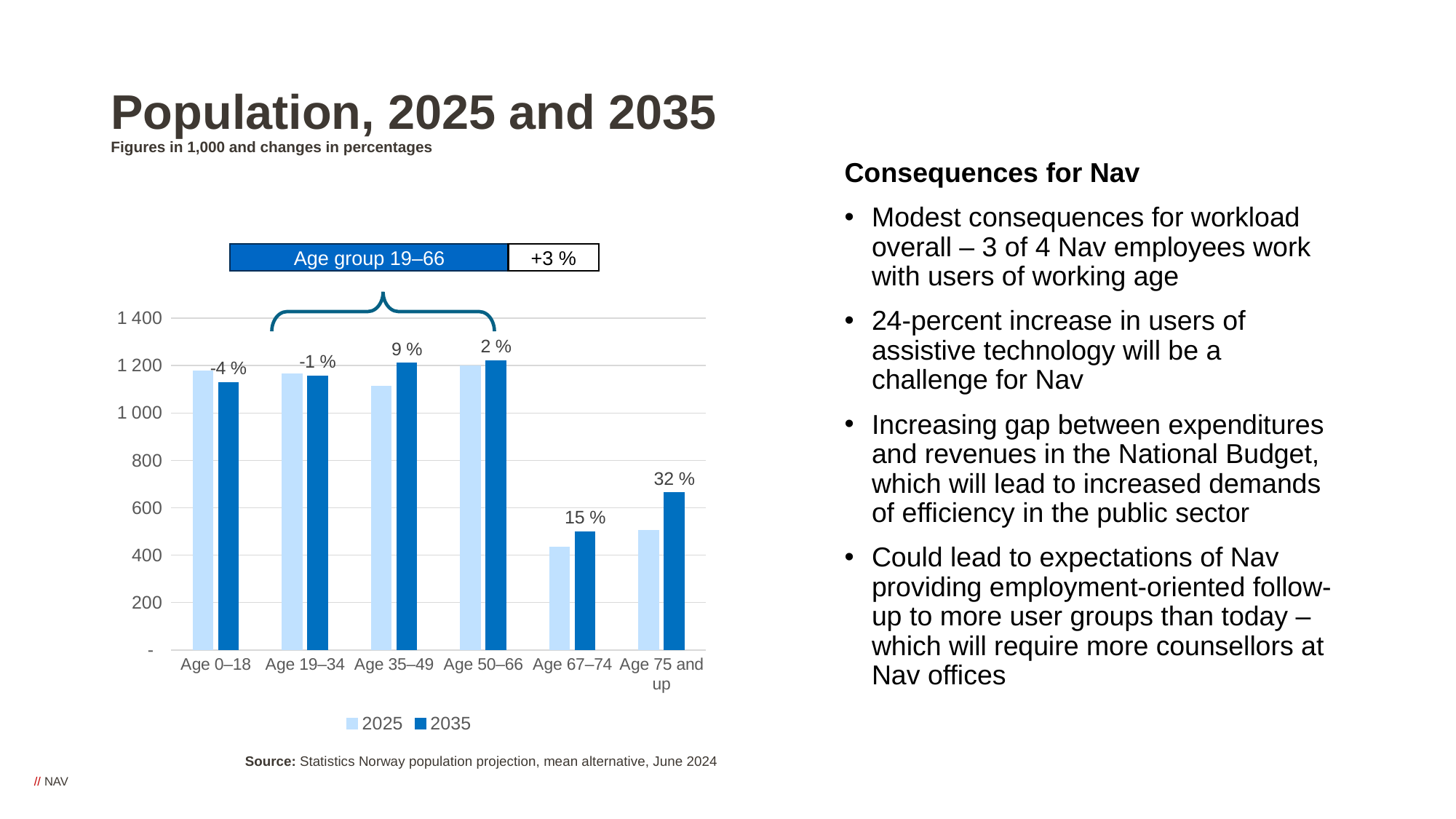
What percentage change is labelled for Age 67–74? 15 % Which age group has the largest labelled percentage change? Age 75 and up Which age group has the lowest labelled percentage change? Age 0–18 What kind of chart is shown on the slide? Bar chart What percentage change is shown in the box for Age group 19–66? +3 % Is the 2025 value for Age 67–74 greater or less than 600? less Is the 2035 value for Age 75 and up greater or less than 600? greater What percentage change is labelled for Age 0–18? -4 % What percentage change is labelled for Age 75 and up? 32 % How many series does the legend list? 2 For Age 35–49, which series has the larger value, 2025 or 2035? 2035 How many age groups are shown on the x axis? 6